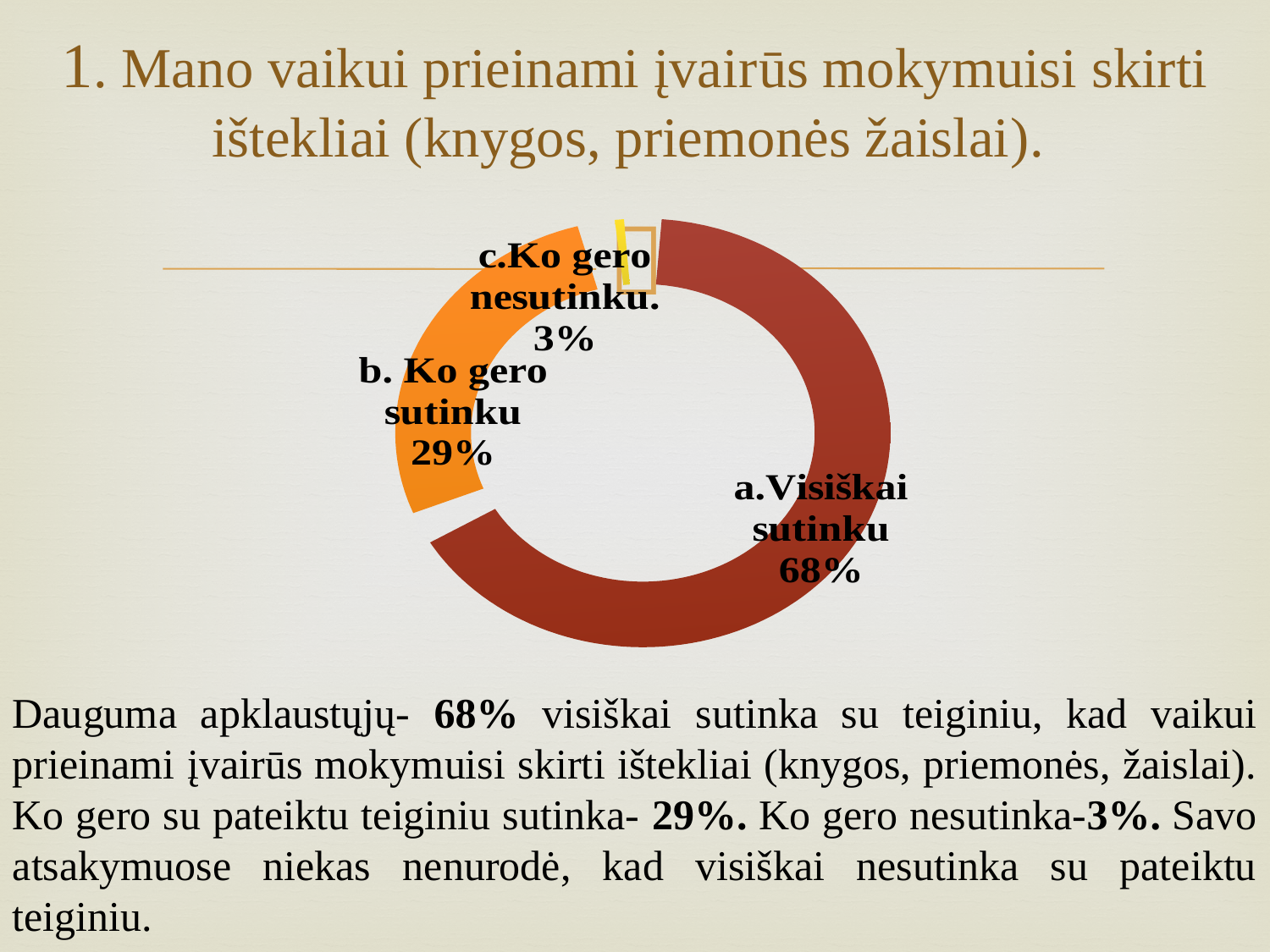
Which category has the smallest share of the chart? c.Ko gero nesutinku. What is the difference in percentage points between "a.Visiškai sutinku" and "b. Ko gero sutinku"? 39 Which is larger: the share for "b. Ko gero sutinku" or for "c.Ko gero nesutinku."? b. Ko gero sutinku Which category has the largest share of the chart? a.Visiškai sutinku How many categories are shown in the chart? 3 What is the difference in percentage points between "b. Ko gero sutinku" and "c.Ko gero nesutinku."? 26 What percentage of respondents chose "a.Visiškai sutinku"? 68% What colour is the slice for "b. Ko gero sutinku"? Orange What kind of chart is shown on the slide? Doughnut (pie) chart What colour is the slice for "a.Visiškai sutinku"? Dark red What percentage of respondents chose "b. Ko gero sutinku"? 29% What percentage of respondents chose "c.Ko gero nesutinku."? 3%